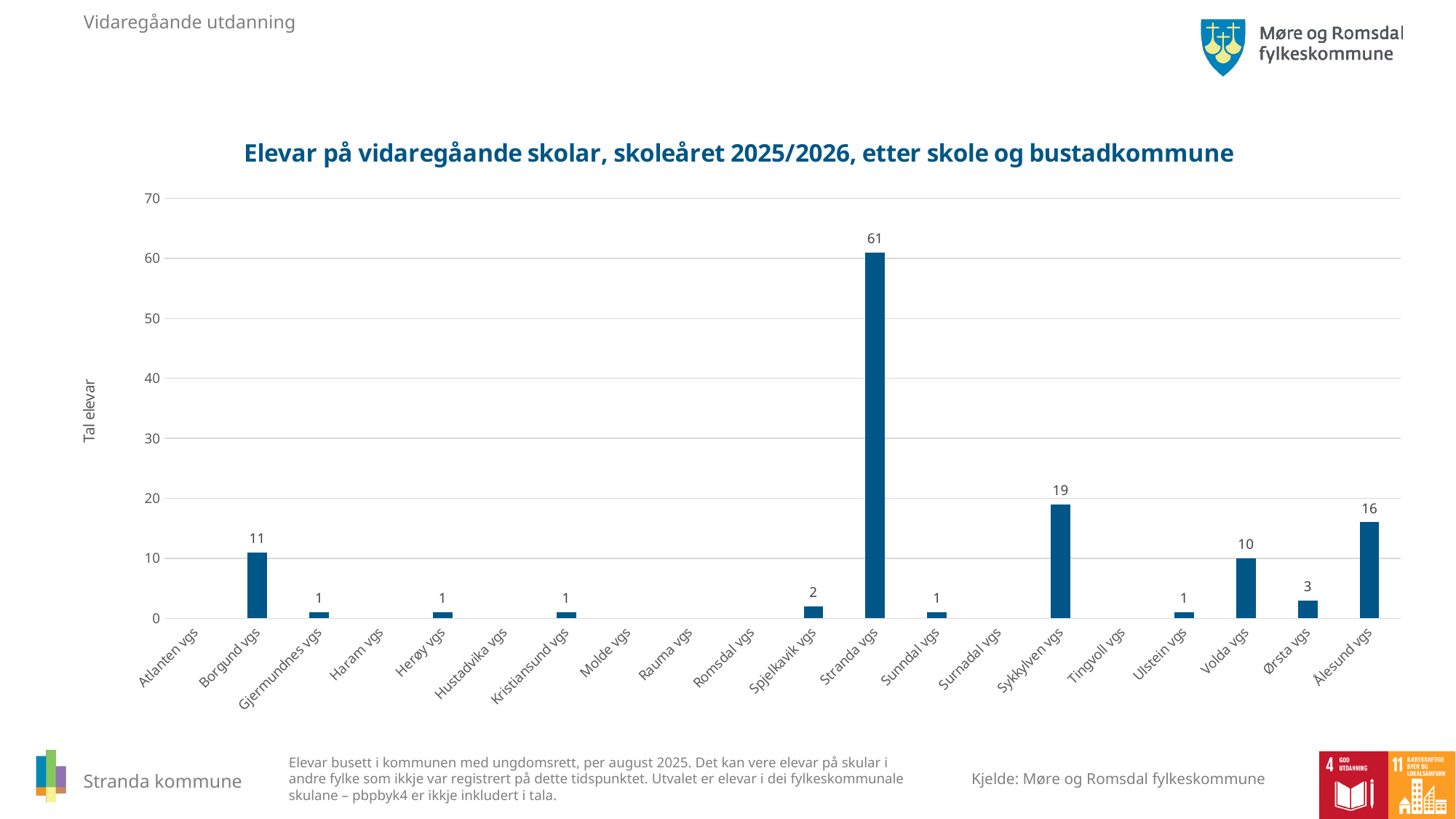
How many schools are listed on the x axis? 20 What is the value for Sykkylven vgs? 19 Which has a larger value, Sykkylven vgs or Ålesund vgs? Sykkylven vgs What is the value for Borgund vgs? 11 What is the value for Ørsta vgs? 3 Is the value for Stranda vgs greater or less than 50? greater What is the difference between the values for Ålesund vgs and Volda vgs? 6 What is the difference between the values for Stranda vgs and Sykkylven vgs? 42 What kind of chart is shown on the slide? Bar chart How many students are shown for Stranda vgs? 61 What is the value for Ålesund vgs? 16 Which school has the highest number of students? Stranda vgs